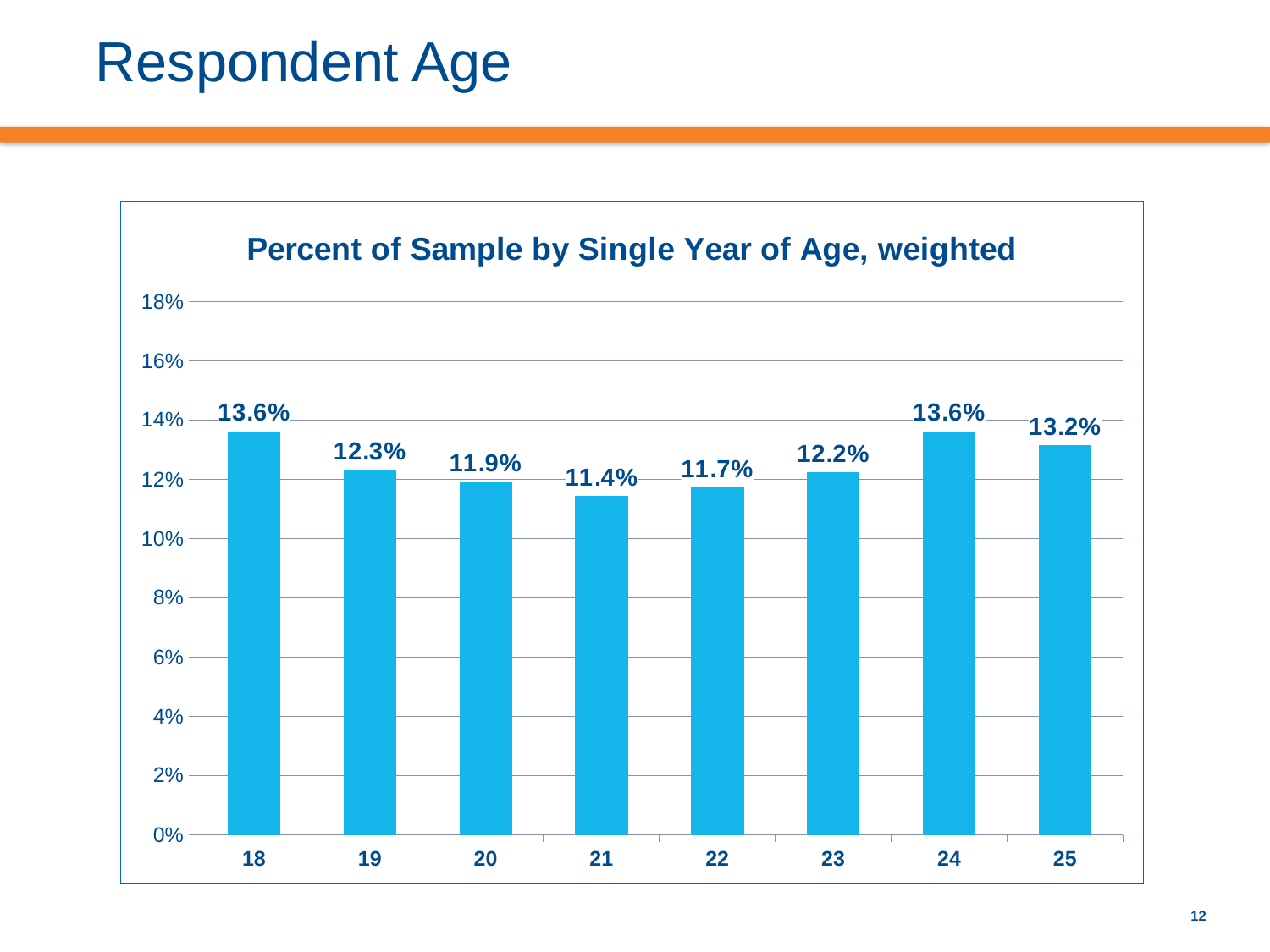
Which age has the lowest percent of the sample? 21 What percent of the sample is age 22? 11.7% What is the title of the chart? Percent of Sample by Single Year of Age, weighted How many age categories are shown on the x axis? 8 What is the difference between the percent for age 24 and the percent for age 25? 0.4% What percent of the sample is age 25? 13.2% What is the difference between the percent for age 18 and the percent for age 21? 2.2% Which has a larger share of the sample, age 19 or age 20? 19 Which has a larger share of the sample, age 23 or age 25? 25 What percent of the sample is age 21? 11.4% What kind of chart is shown on the slide? Bar chart What percent of the sample is age 18? 13.6%